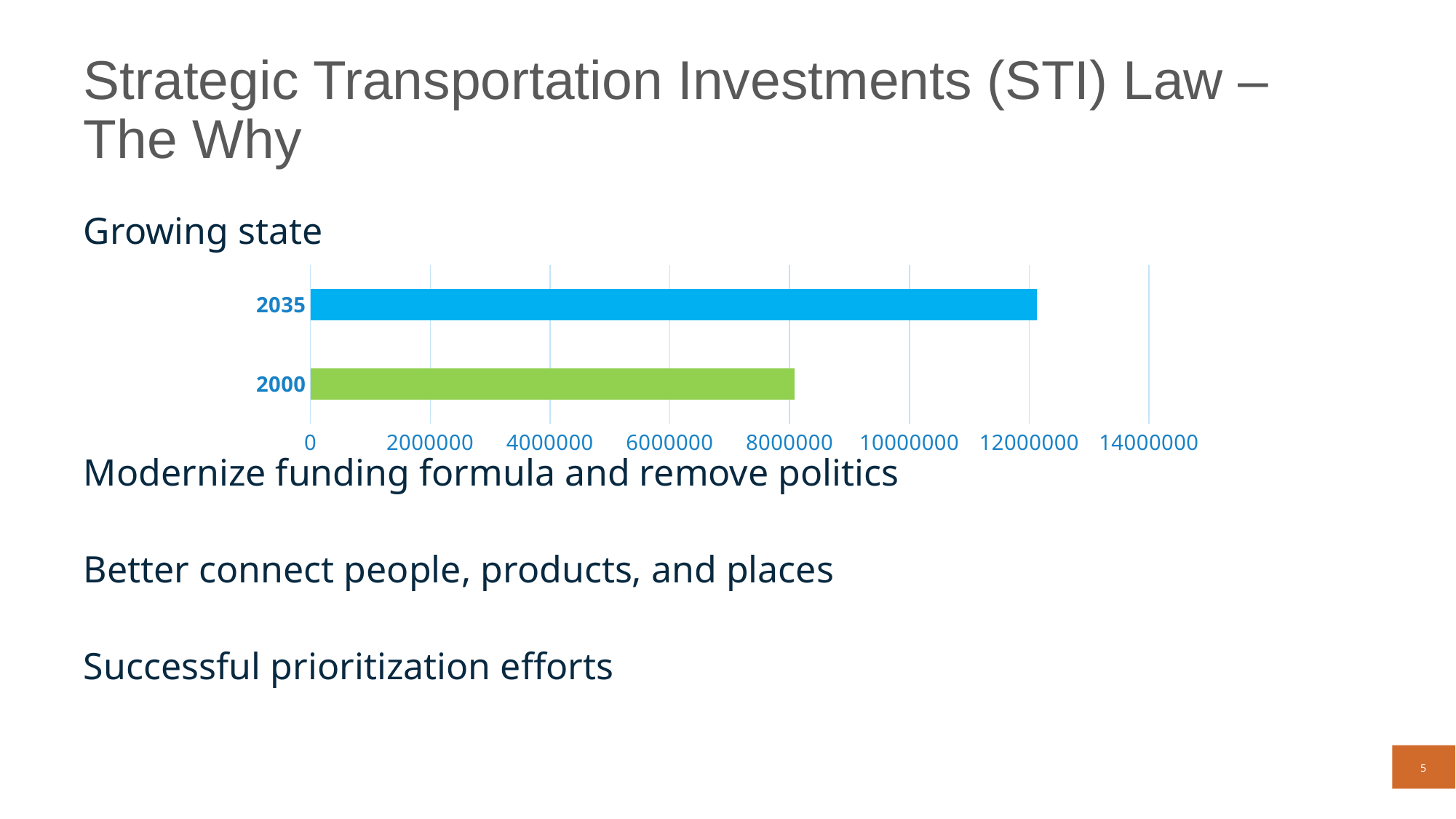
How many categories does the chart show? 2 Is the value for 2035 greater or less than 14000000? less What kind of chart is shown on the slide? bar chart What is the highest tick label shown on the value axis? 14000000 Does the value increase or decrease from 2000 to 2035? increase Which category has the highest value in the chart? 2035 Which has the larger value, 2000 or 2035? 2035 What colour is the bar for 2035? blue Is the value for 2000 greater or less than 10000000? less Which category has the lowest value in the chart? 2000 Is the value for 2000 greater or less than 6000000? greater